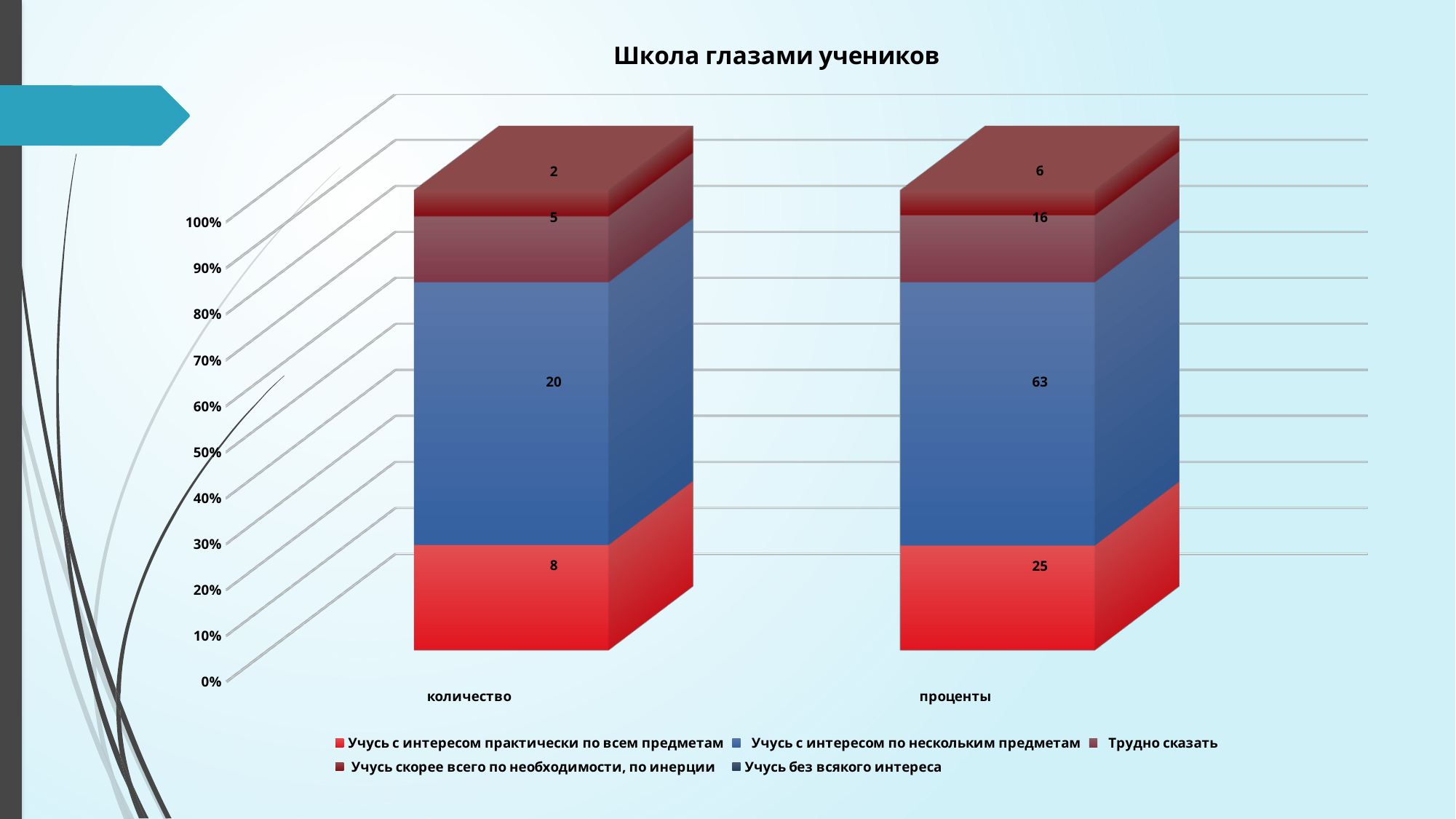
How many categories are shown on the x axis? 2 What is the value of "Трудно сказать" for "проценты"? 16 Which series has the smallest labelled segment in the "количество" bar? Учусь скорее всего по необходимости, по инерции What is the value of "Учусь с интересом практически по всем предметам" for "проценты"? 25 What is the difference between the "Учусь с интересом по нескольким предметам" and "Учусь с интересом практически по всем предметам" values for "проценты"? 38 What is the title of the chart? Школа глазами учеников Which series has the largest segment in the "проценты" bar? Учусь с интересом по нескольким предметам What kind of chart is shown on the slide? Stacked bar chart What is the value of "Учусь с интересом по нескольким предметам" for "количество"? 20 How many series does the legend list? 5 What is the total of the labelled segments in the "количество" bar? 35 What is the value of "Учусь скорее всего по необходимости, по инерции" for "количество"? 2